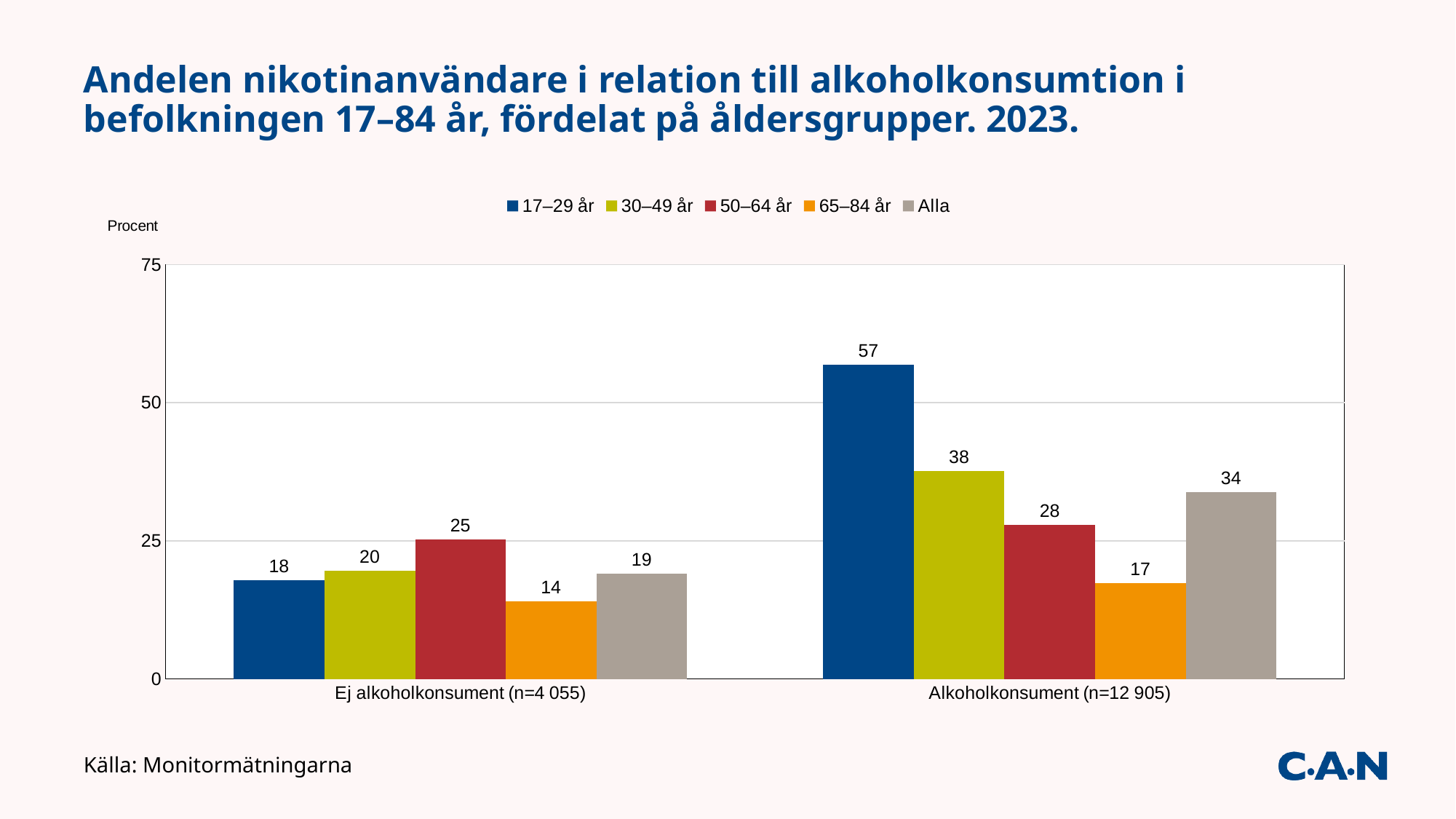
Which is larger: the 50–64 år value for Ej alkoholkonsument (n=4 055) or the 30–49 år value for Ej alkoholkonsument (n=4 055)? 50–64 år Which age group has the lowest value in the Ej alkoholkonsument (n=4 055) category? 65–84 år Which age group has the highest value in the Alkoholkonsument (n=12 905) category? 17–29 år How many categories are shown on the x axis? 2 What is the value for the 17–29 år series in the Alkoholkonsument (n=12 905) category? 57 What kind of chart is shown on the slide? Bar chart What is the source given at the bottom of the slide? Monitormätningarna What is the value for the 65–84 år series in the Ej alkoholkonsument (n=4 055) category? 14 Is the value for 30–49 år in the Alkoholkonsument (n=12 905) category greater or less than 25? greater What is the value for the Alla series in the Alkoholkonsument (n=12 905) category? 34 What is the difference between the 17–29 år values for Alkoholkonsument (n=12 905) and Ej alkoholkonsument (n=4 055)? 39 How many series does the legend list? 5